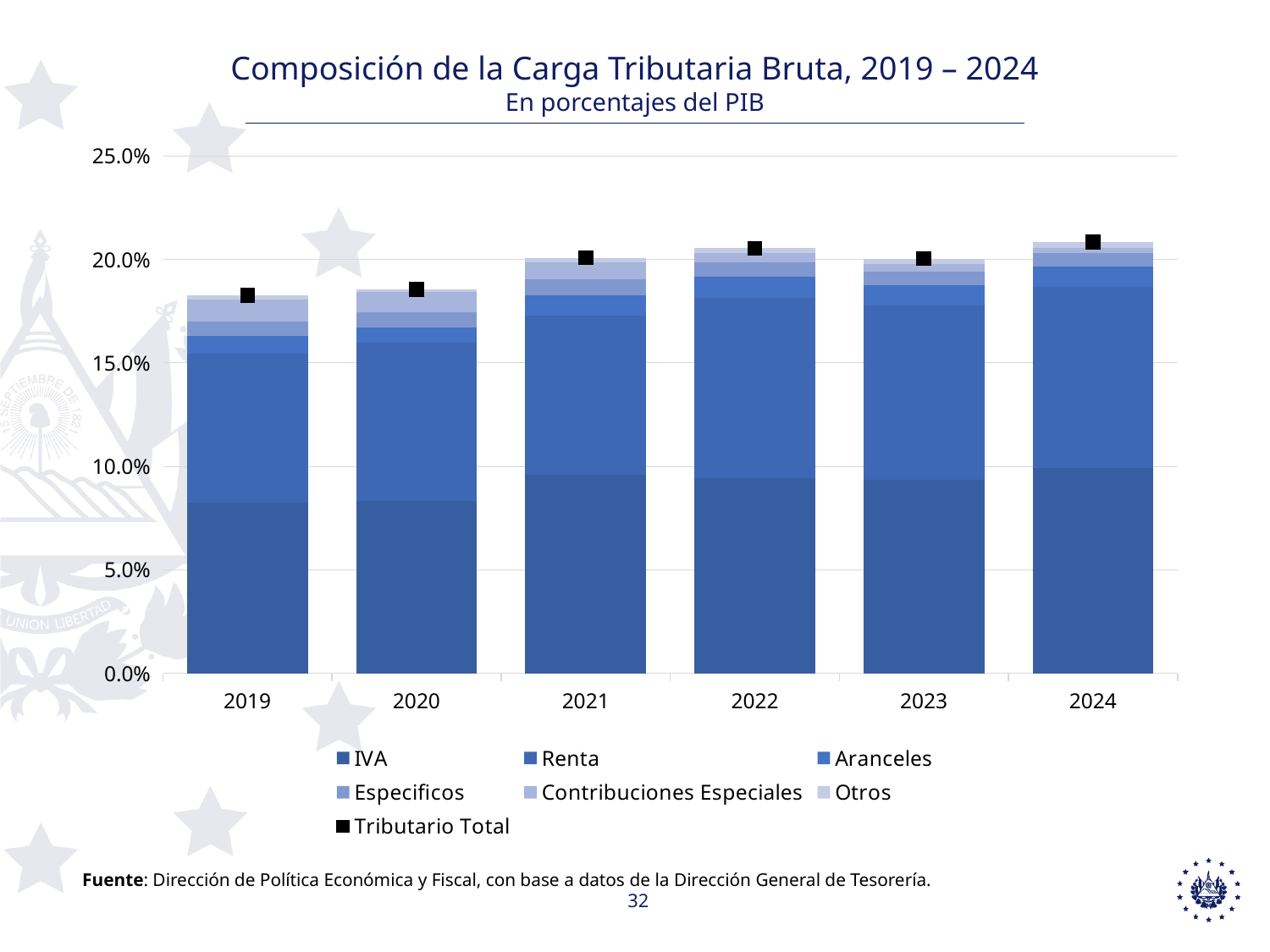
What is the title of the chart? Composición de la Carga Tributaria Bruta, 2019 – 2024 Which year has a larger IVA value, 2019 or 2021? 2021 Which year has the highest Tributario Total value? 2024 Is the Tributario Total value for 2024 greater or less than 20.0%? greater Is the Tributario Total value for 2019 greater or less than 20.0%? less Do the Tributario Total values generally rise or fall from 2019 to 2024? rise How many series does the chart's legend list? 7 In what unit are the values expressed, according to the chart's subtitle? En porcentajes del PIB How many years are shown on the x axis of the chart? 6 Is the IVA value for 2019 greater or less than 10.0%? less What kind of chart is shown on the slide? Stacked bar chart Which year has the lowest Tributario Total value? 2019